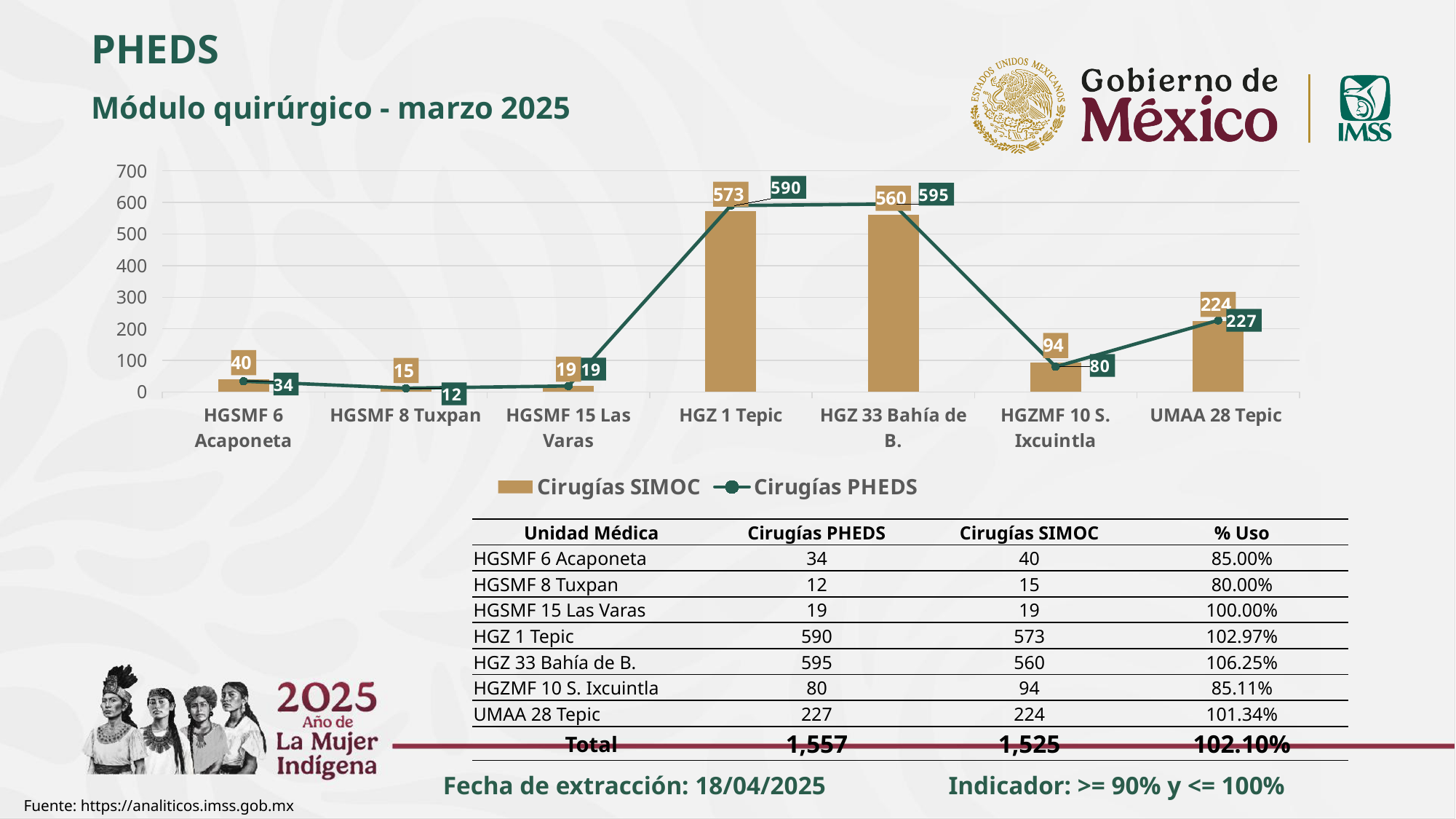
Which series is drawn as a line with markers in the chart? Cirugías PHEDS How many series does the chart legend list? 2 Which unit has the highest Cirugías SIMOC value? HGZ 1 Tepic How many medical units are shown on the x axis of the chart? 7 What is the Cirugías PHEDS value for HGSMF 8 Tuxpan? 12 Is the Cirugías SIMOC value for UMAA 28 Tepic greater or less than 200? greater What is the Cirugías PHEDS value for HGZ 33 Bahía de B.? 595 What is the difference between Cirugías PHEDS and Cirugías SIMOC for HGZ 33 Bahía de B.? 35 What is the Cirugías SIMOC value for HGZ 1 Tepic? 573 Which unit has the lowest Cirugías PHEDS value? HGSMF 8 Tuxpan For HGZMF 10 S. Ixcuintla, which is larger: Cirugías SIMOC or Cirugías PHEDS? Cirugías SIMOC What kind of chart is used to show Cirugías SIMOC? Bar chart